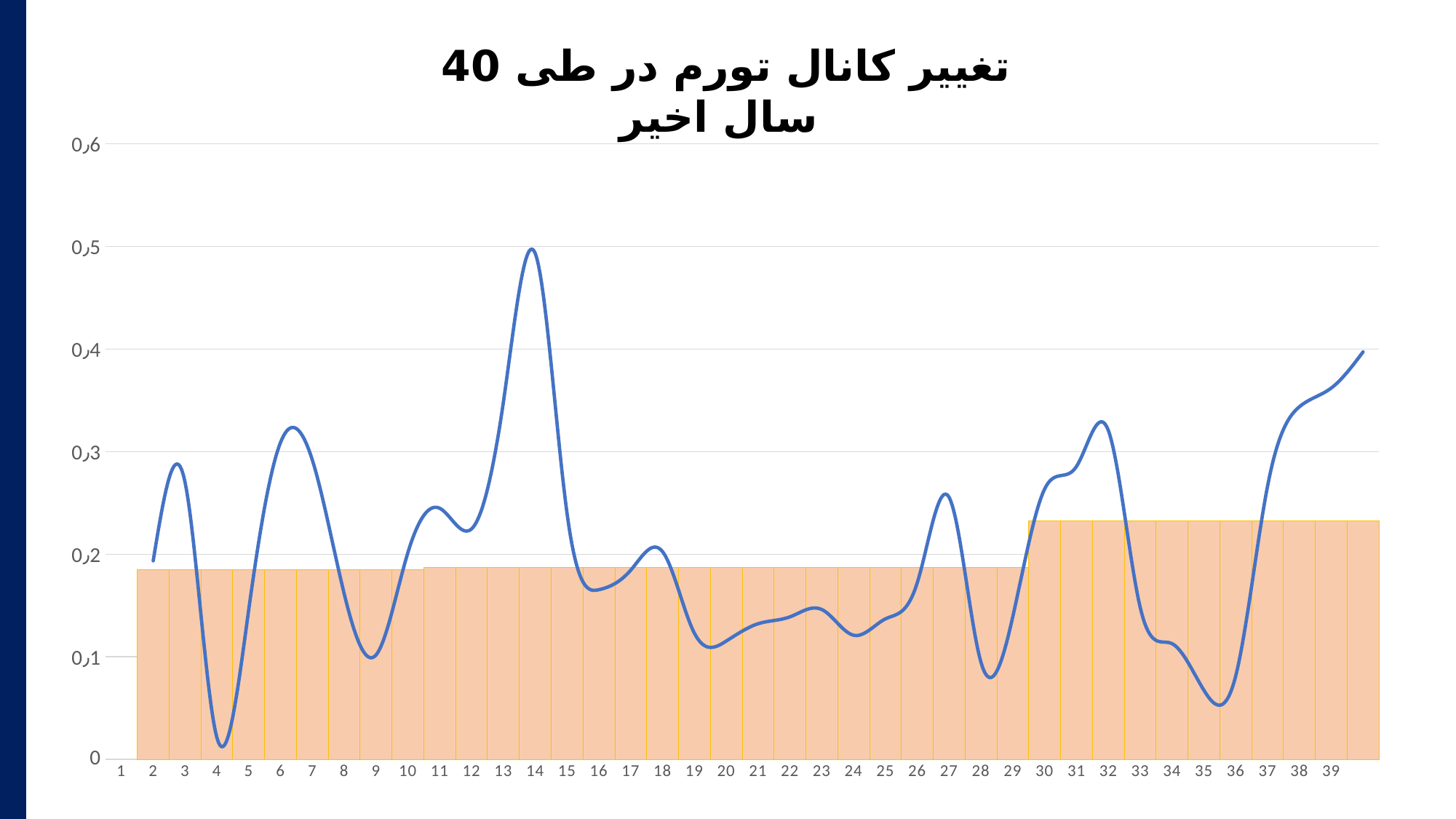
Is the value of the blue line at point 14 greater or less than 0,4? greater Is the value of the blue line at point 4 greater or less than 0,1? less At which x-axis point does the blue line reach its highest value? 14 Is the height of the orange bar at point 35 greater or less than 0,2? greater At which x-axis point does the blue line reach its lowest value? 4 What is the highest value shown on the y axis? 0,6 What kind of chart is shown on the slide? A combined line and bar chart Does the blue line rise or fall between points 36 and 39? rise What is the title of the chart? تغییر کانال تورم در طی 40 سال اخیر